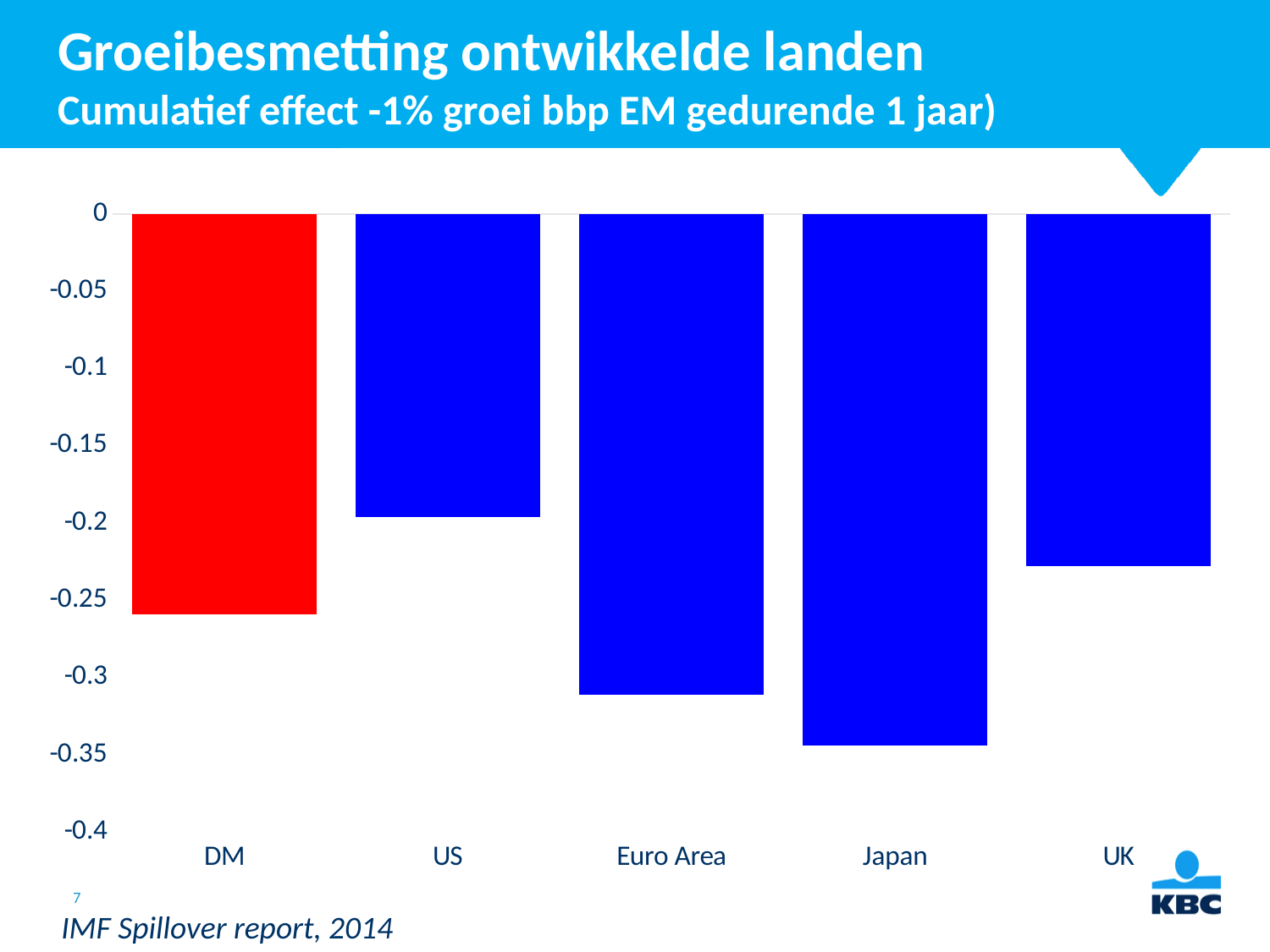
Which has the more negative value, Japan or DM? Japan Is the value for UK greater or less than -0.25? greater Which category has the lowest (most negative) value in the chart? Japan What kind of chart is shown on the slide? bar chart Which category has the highest value (closest to zero) in the chart? US How many categories are shown on the x axis of the chart? 5 Which has the more negative value, Euro Area or UK? Euro Area Is the value for Japan greater or less than -0.3? less Is the value for US greater or less than -0.25? greater Which bar in the chart is coloured red? DM